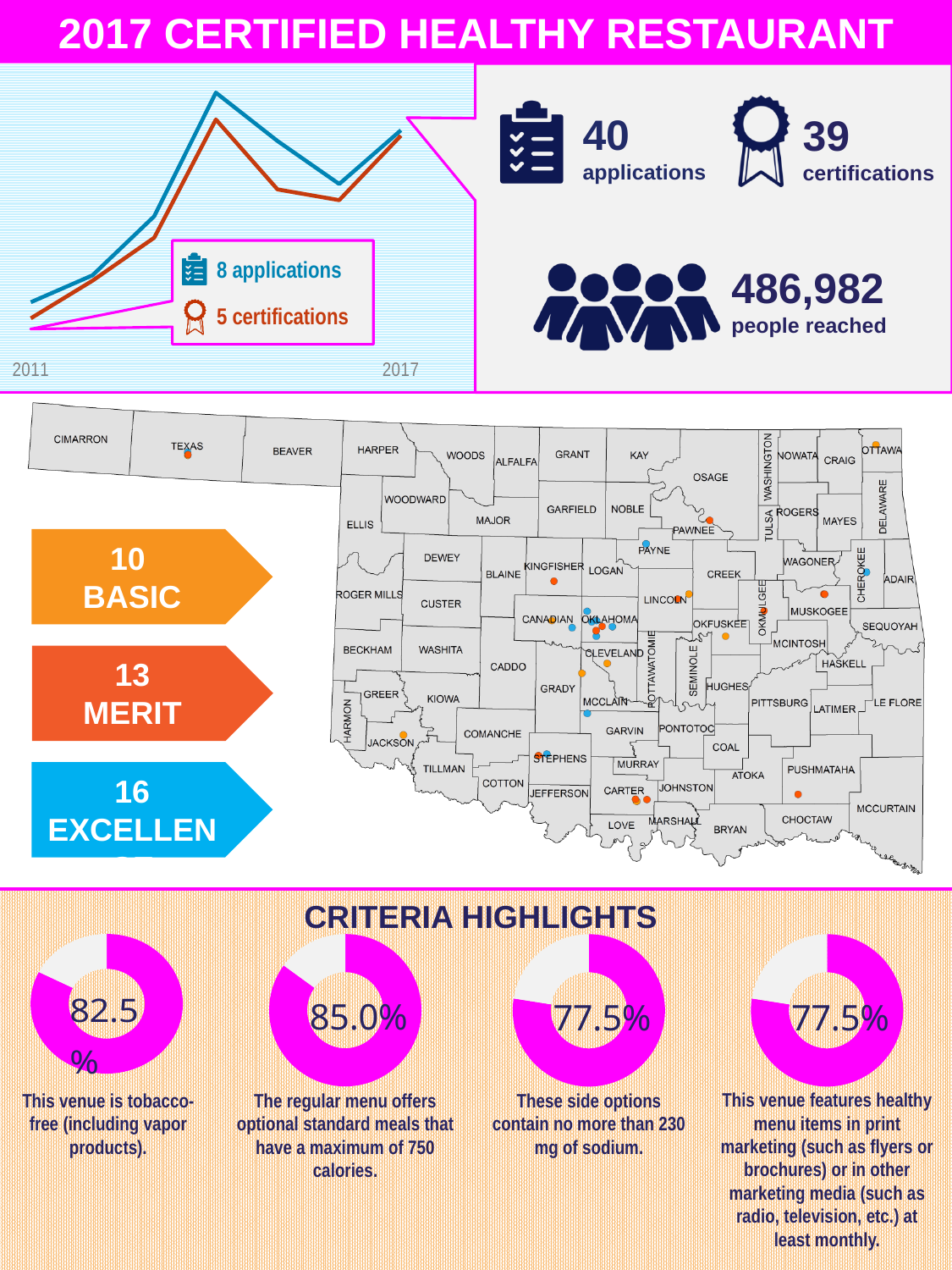
On the line chart at the top left, how many applications were there in 2011? 8 In the Criteria Highlights section, what percentage is shown for 'This venue is tobacco-free (including vapor products)'? 82.5% In the Criteria Highlights section, what percentage is shown for 'The regular menu offers optional standard meals that have a maximum of 750 calories'? 85.0% On the line chart at the top left, how many certifications were there in 2017? 39 On the line chart at the top left, what is the difference between applications and certifications in 2017? 1 What kind of chart is shown at the top left of the slide, spanning 2011 to 2017? Line chart On the line chart at the top left, how many applications were there in 2017? 40 How many donut charts are shown in the Criteria Highlights section? 4 On the line chart at the top left, how many certifications were there in 2011? 5 On the line chart at the top left, do the values rise or fall overall from 2011 to 2017? Rise In the Criteria Highlights section, which criterion has the highest percentage? The regular menu offers optional standard meals that have a maximum of 750 calories (85.0%) On the line chart at the top left, which was larger in 2011: applications or certifications? Applications